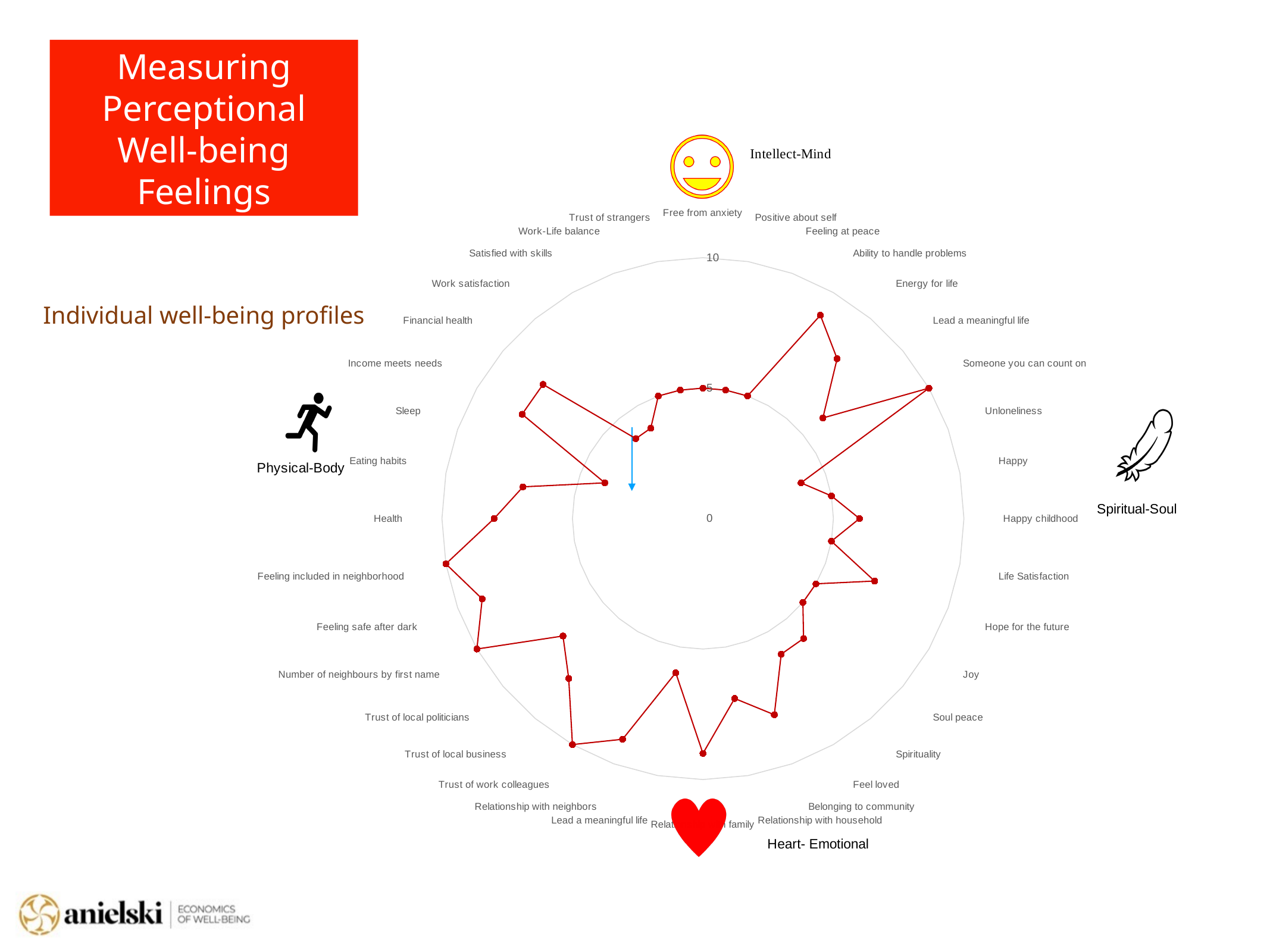
Is the value for Work satisfaction greater or less than 5? less Which has the larger value, Someone you can count on or Unloneliness? Someone you can count on Is the value for Health greater or less than 5? greater What is the highest value marked on the chart's axis? 10 Is the value for Satisfied with skills greater or less than 5? less Which has the larger value, Health or Sleep? Health Which well-being domain is labelled at the top of the chart next to the smiley face? Intellect-Mind What kind of chart is shown on the slide? Radar chart